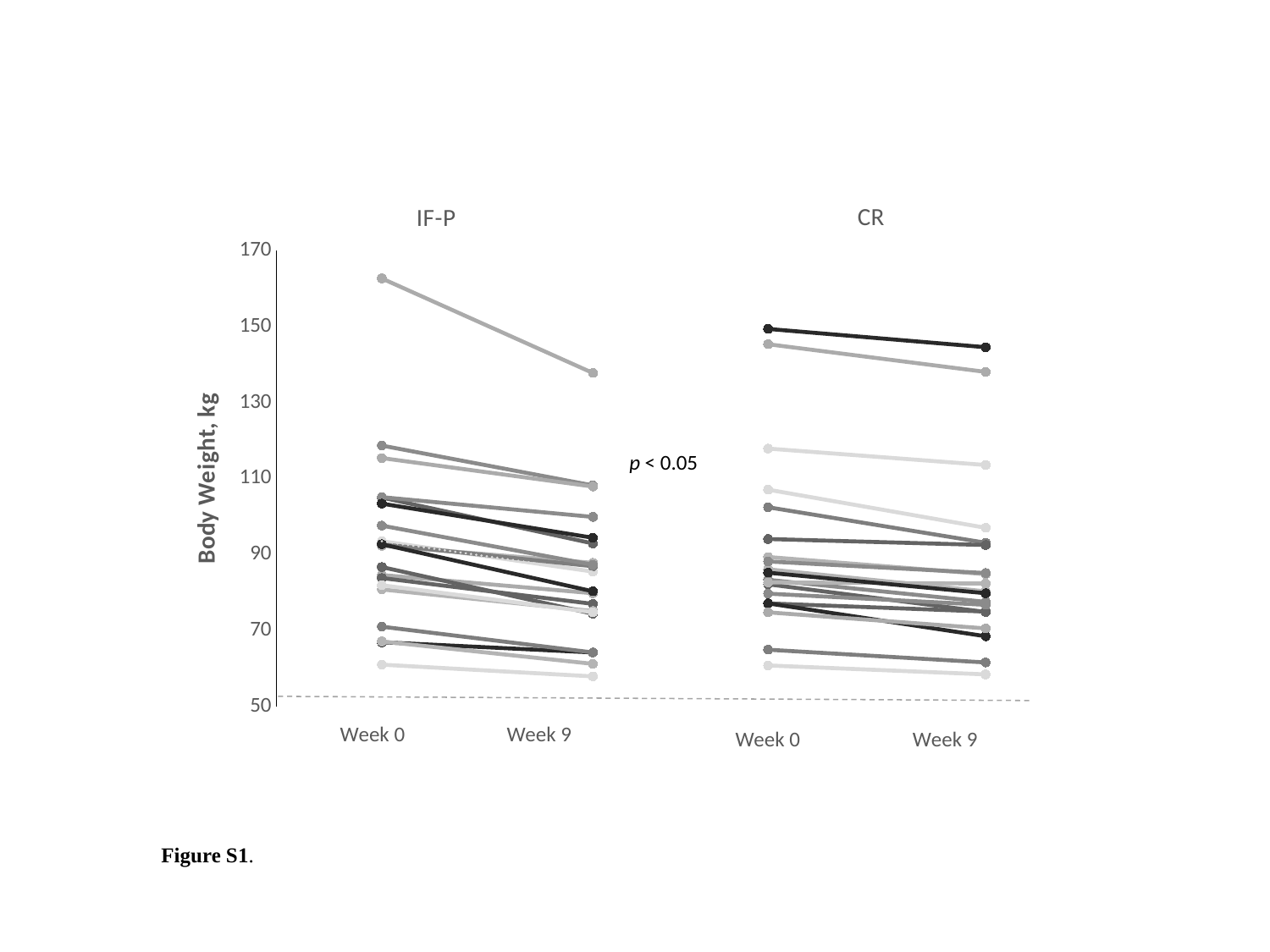
In the IF-P panel, is the lowest Week 0 value greater or less than 70? less In the IF-P panel, is the highest Week 9 value greater or less than 130? greater What kind of chart is shown on the slide? line chart How many time points are shown on the x axis of each panel? 2 What is the title of the y axis? Body Weight, kg In the IF-P panel, do the body weight values generally rise or fall from Week 0 to Week 9? fall In the CR panel, is the highest Week 0 value greater or less than 130? greater What statistical annotation is printed between the two panels? p < 0.05 What is the highest tick value shown on the y axis? 170 In the CR panel, do the body weight values generally rise or fall from Week 0 to Week 9? fall